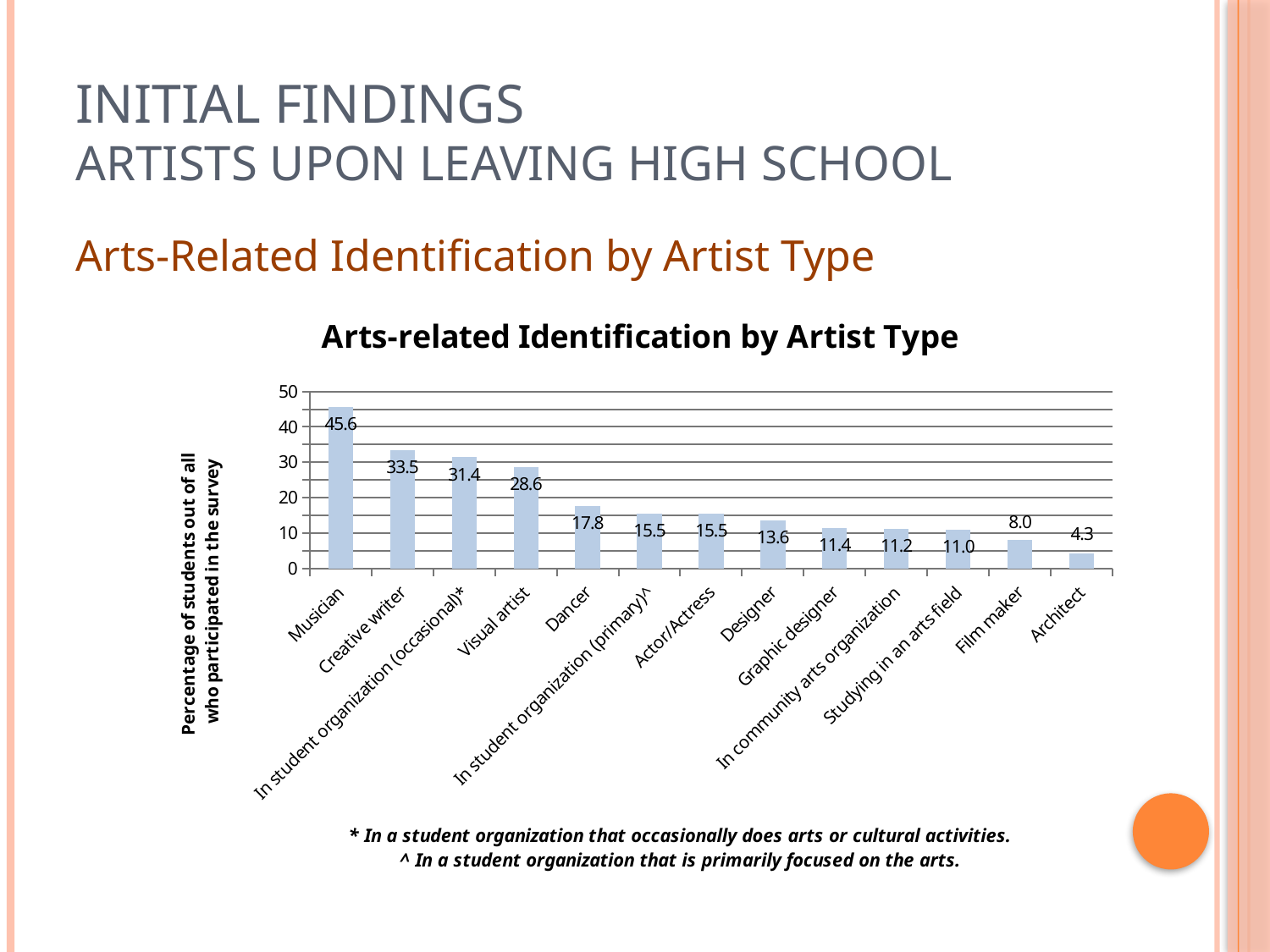
What kind of chart is this? bar chart Is the value for Film maker greater or less than 10? less What is the value for Creative writer? 33.5 What is the value for Musician? 45.6 What is the value for Graphic designer? 11.4 What is the value for Architect? 4.3 Which category has the highest value? Musician Which category has the lowest value? Architect What is the difference between the values for Musician and Creative writer? 12.1 How many categories are shown on the x axis? 13 What is the title of the chart? Arts-related Identification by Artist Type Which is larger, the value for Visual artist or the value for Dancer? Visual artist